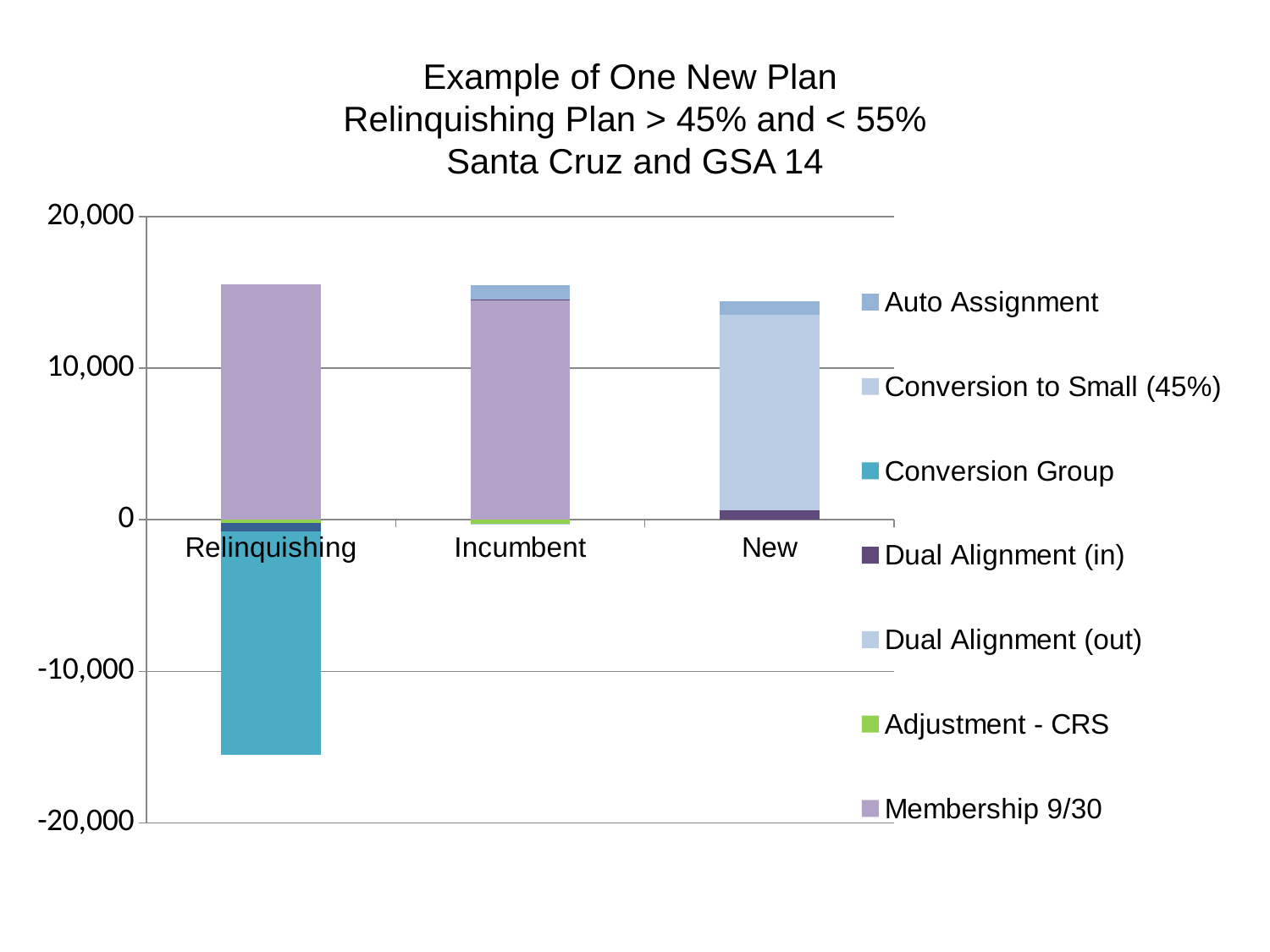
How many categories are shown on the x axis of the chart? 3 What is the first line of the chart's title? Example of One New Plan How many series does the chart's legend list? 7 Which category has a large negative Conversion Group segment extending below -10,000? Relinquishing Which category's bar is made up mostly of the Conversion to Small (45%) series? New What is the highest value shown on the y axis? 20,000 What kind of chart is shown on the slide? Stacked bar chart Is the Membership 9/30 value for Relinquishing greater or less than 10,000? greater Which category has the lowest total positive stacked height? New Is the Membership 9/30 value for Incumbent greater or less than 10,000? greater Is the Conversion to Small (45%) value for New greater or less than 10,000? greater